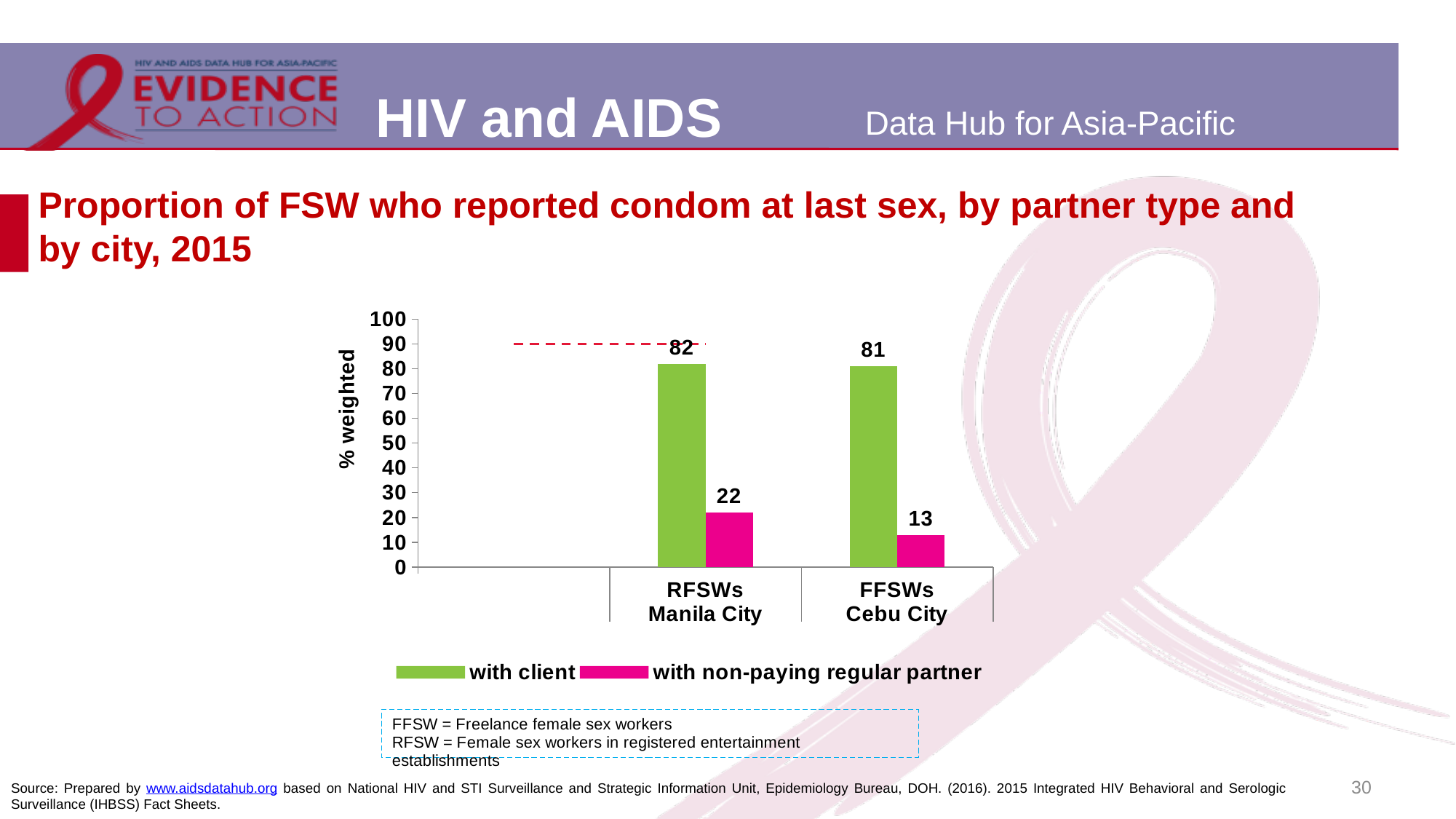
What is the difference between the 'with non-paying regular partner' values for RFSWs Manila City and FFSWs Cebu City? 9 Which is larger for FFSWs Cebu City: the 'with client' value or the 'with non-paying regular partner' value? with client What is the value for 'with client' for RFSWs Manila City? 82 How many series does the legend list? 2 Which category has the lowest value for 'with non-paying regular partner'? FFSWs Cebu City Is the 'with client' value for RFSWs Manila City greater or less than 90? less What kind of chart is shown on the slide? bar chart What is the value for 'with non-paying regular partner' for RFSWs Manila City? 22 What is the value for 'with client' for FFSWs Cebu City? 81 What is the value for 'with non-paying regular partner' for FFSWs Cebu City? 13 What is the difference between the 'with client' and 'with non-paying regular partner' values for RFSWs Manila City? 60 How many categories are shown on the x axis? 2